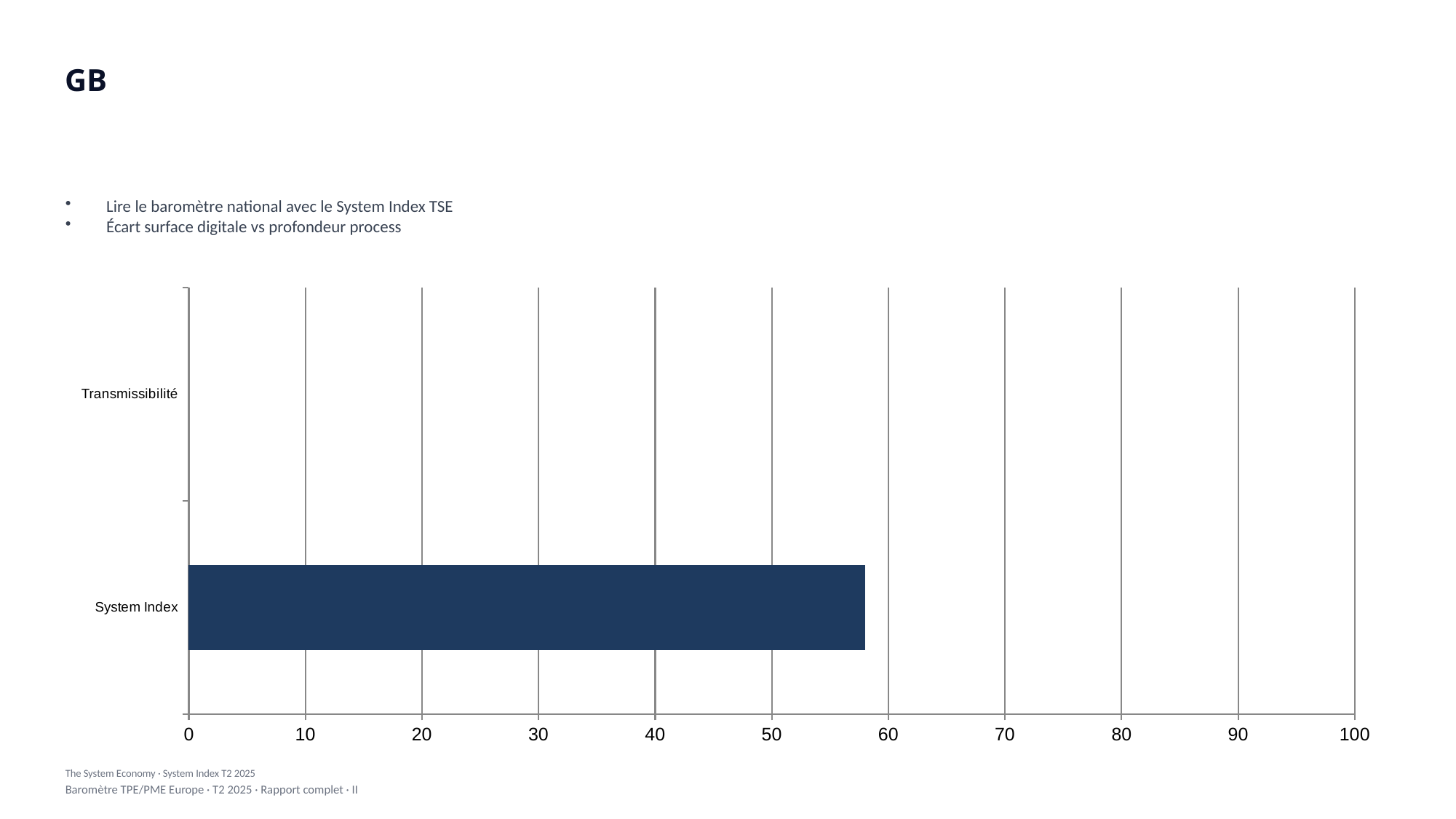
How many categories are shown on the chart's vertical axis? 2 Which is larger, the value for System Index or the value for Transmissibilité? System Index Is the value for System Index greater or less than 40? greater What kind of chart is shown on the slide? bar chart Is the value for System Index greater or less than 50? greater What is the maximum value shown on the chart's horizontal axis? 100 Is the value for System Index greater or less than 60? less Which category has the highest value on the chart? System Index What is the title of the slide containing the chart? GB